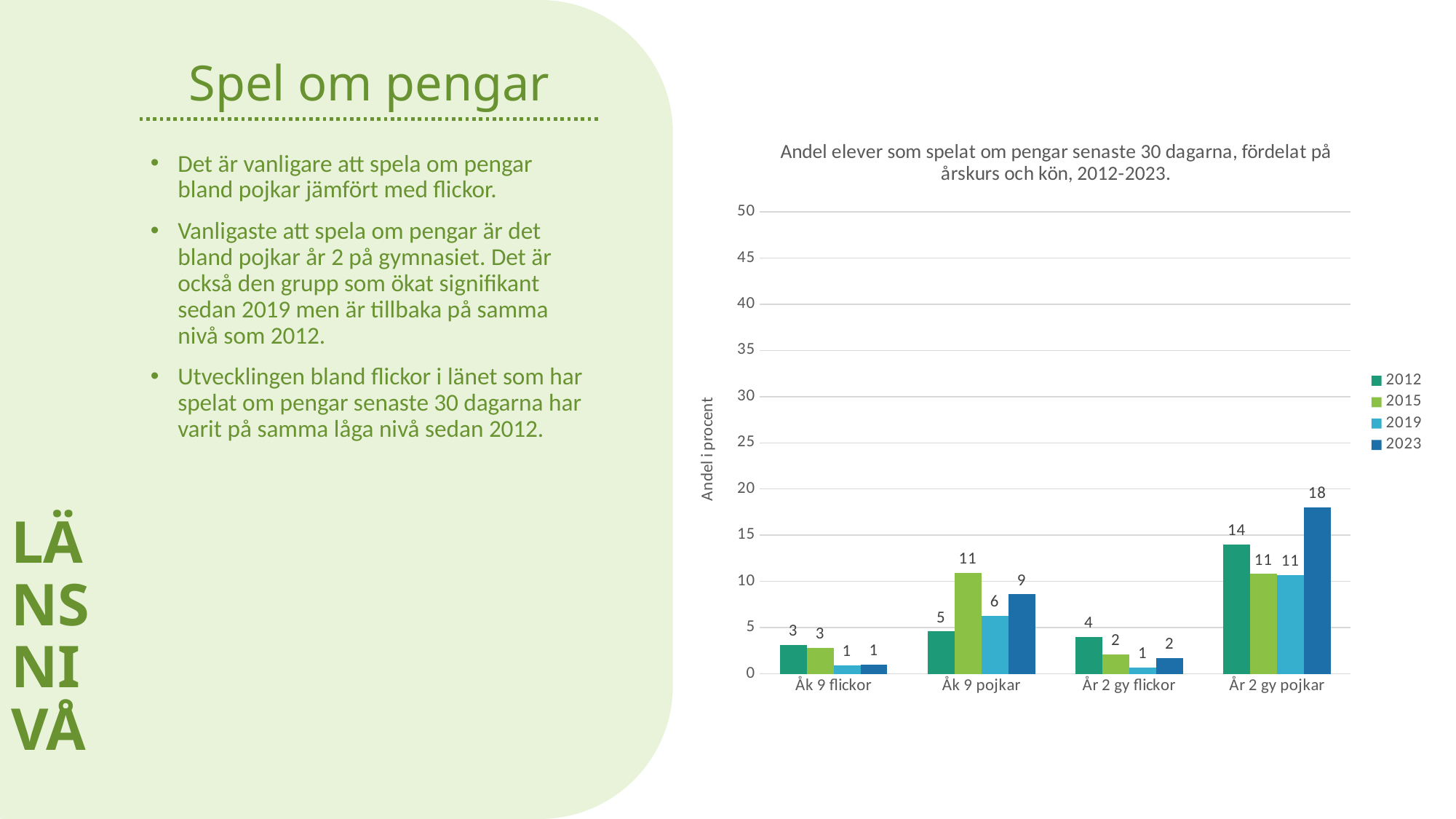
Is the value for År 2 gy pojkar in 2023 greater or less than 15? greater Which category has the highest value for the 2023 series? År 2 gy pojkar Which is larger for Åk 9 pojkar: the 2015 value or the 2023 value? 2015 How many series does the legend list? 4 What is the value for År 2 gy pojkar in 2023? 18 What is the label of the vertical axis? Andel i procent What kind of chart is shown on the slide? Bar chart What is the value for Åk 9 pojkar in 2015? 11 What is the value for År 2 gy flickor in 2012? 4 How many categories are shown on the x axis? 4 Which category has the lowest value for the 2012 series? Åk 9 flickor What is the difference between the 2023 and 2012 values for År 2 gy pojkar? 4